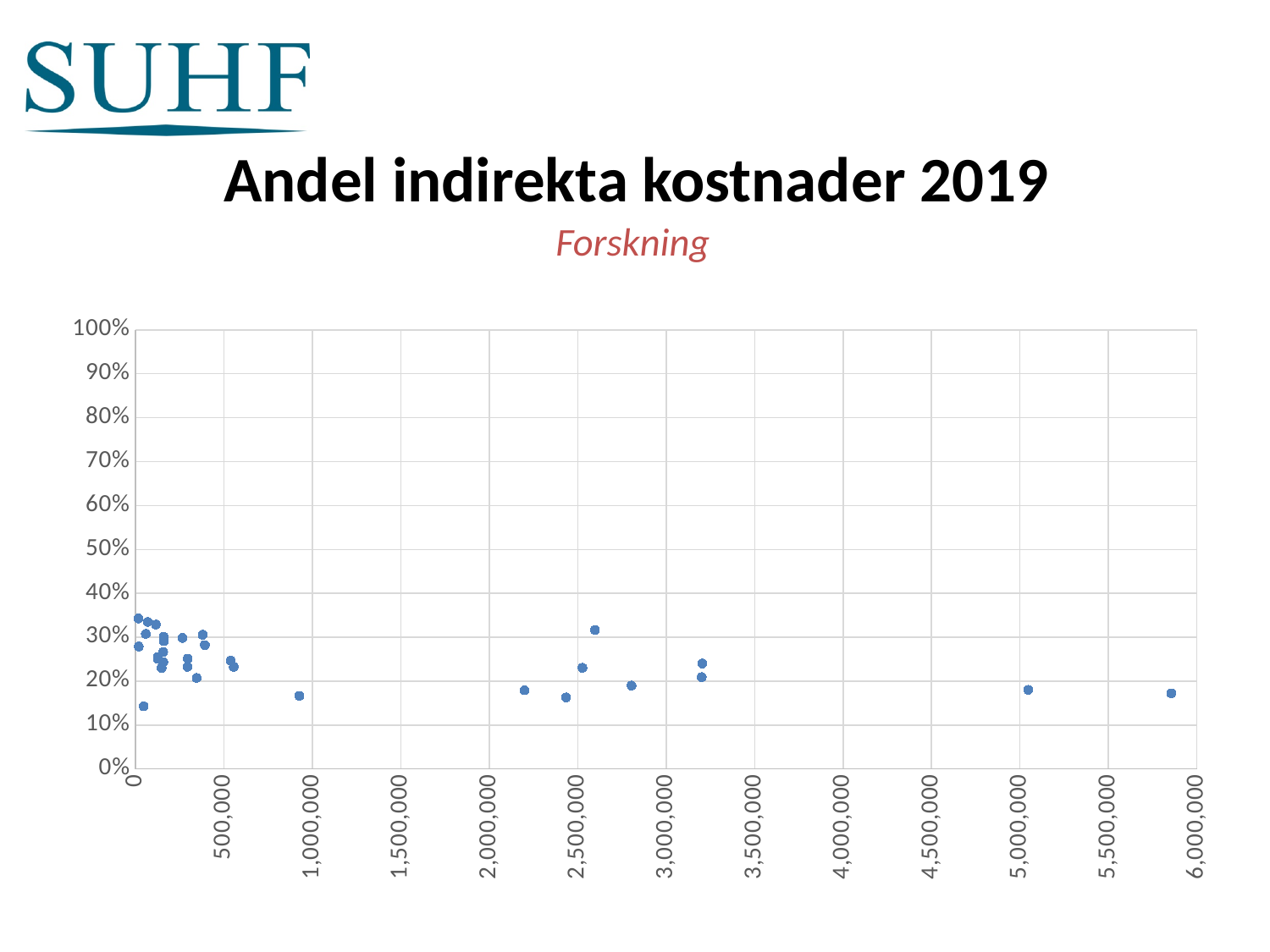
How many points lie between 1,000,000 and 2,000,000 on the x axis? 0 Are any points on the chart above 50%? No How many points lie to the right of 4,000,000 on the x axis? 2 What is the highest value shown on the y axis? 100% What kind of chart is shown on the slide? scatter chart Is the value of the rightmost point (near 6,000,000 on the x axis) greater or less than 20%? less What subtitle appears in red below the chart title? Forskning Is the value of the point near 1,000,000 on the x axis greater or less than 20%? less Do the points at the far right of the x axis sit higher or lower than most of the points clustered near the left? lower What is the title of the chart on the slide? Andel indirekta kostnader 2019